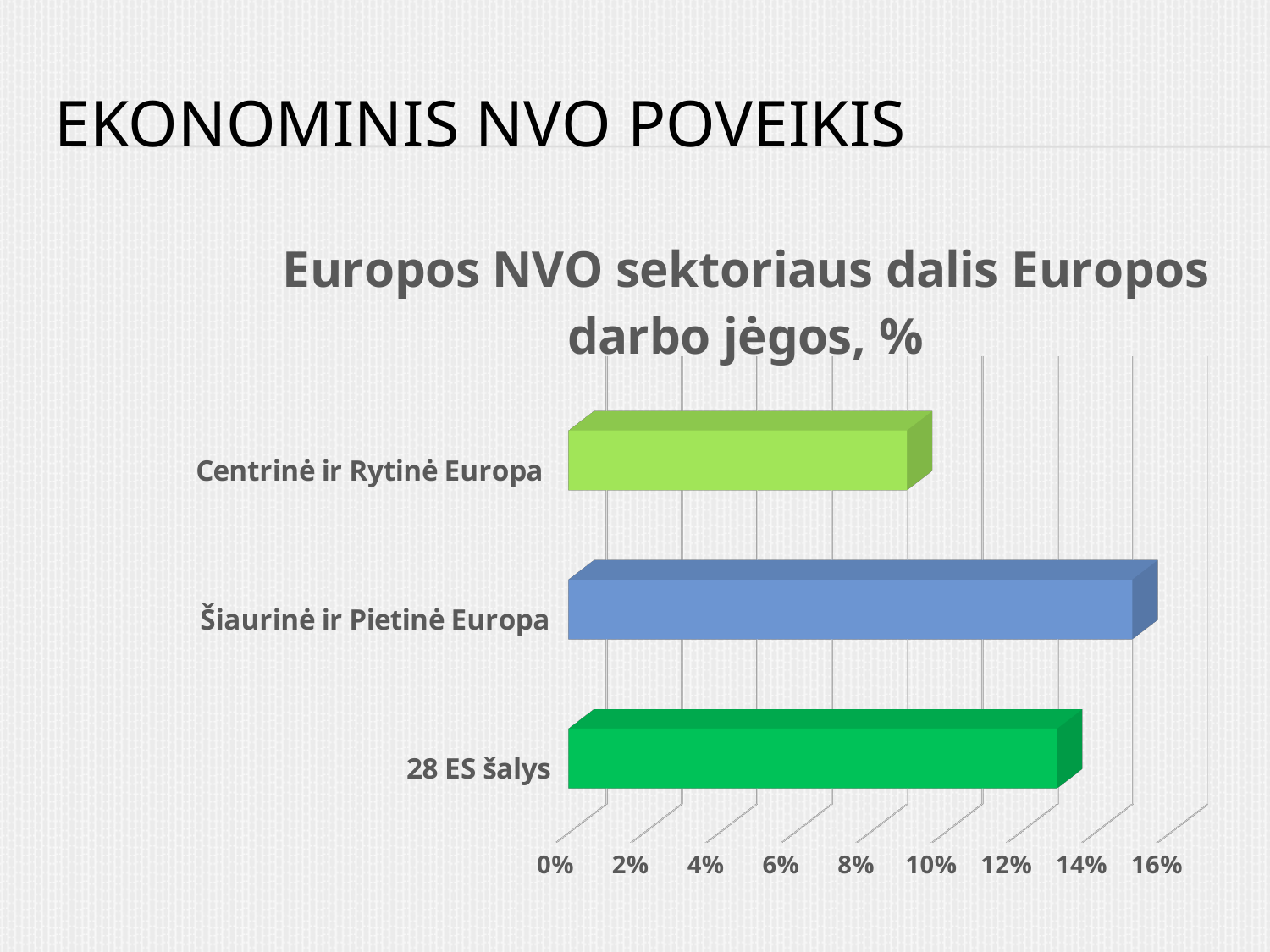
What kind of chart is shown on the slide? bar chart Which category has the highest value? Šiaurinė ir Pietinė Europa Is the value for 28 ES šalys greater or less than 14%? less Which is larger, the value for Šiaurinė ir Pietinė Europa or the value for 28 ES šalys? Šiaurinė ir Pietinė Europa Is the value for Šiaurinė ir Pietinė Europa greater or less than 14%? greater Which category has the lowest value? Centrinė ir Rytinė Europa Is the value for Centrinė ir Rytinė Europa greater or less than 8%? greater What is the title of the chart? Europos NVO sektoriaus dalis Europos darbo jėgos, % How many categories are plotted in the chart? 3 Which is larger, the value for 28 ES šalys or the value for Centrinė ir Rytinė Europa? 28 ES šalys